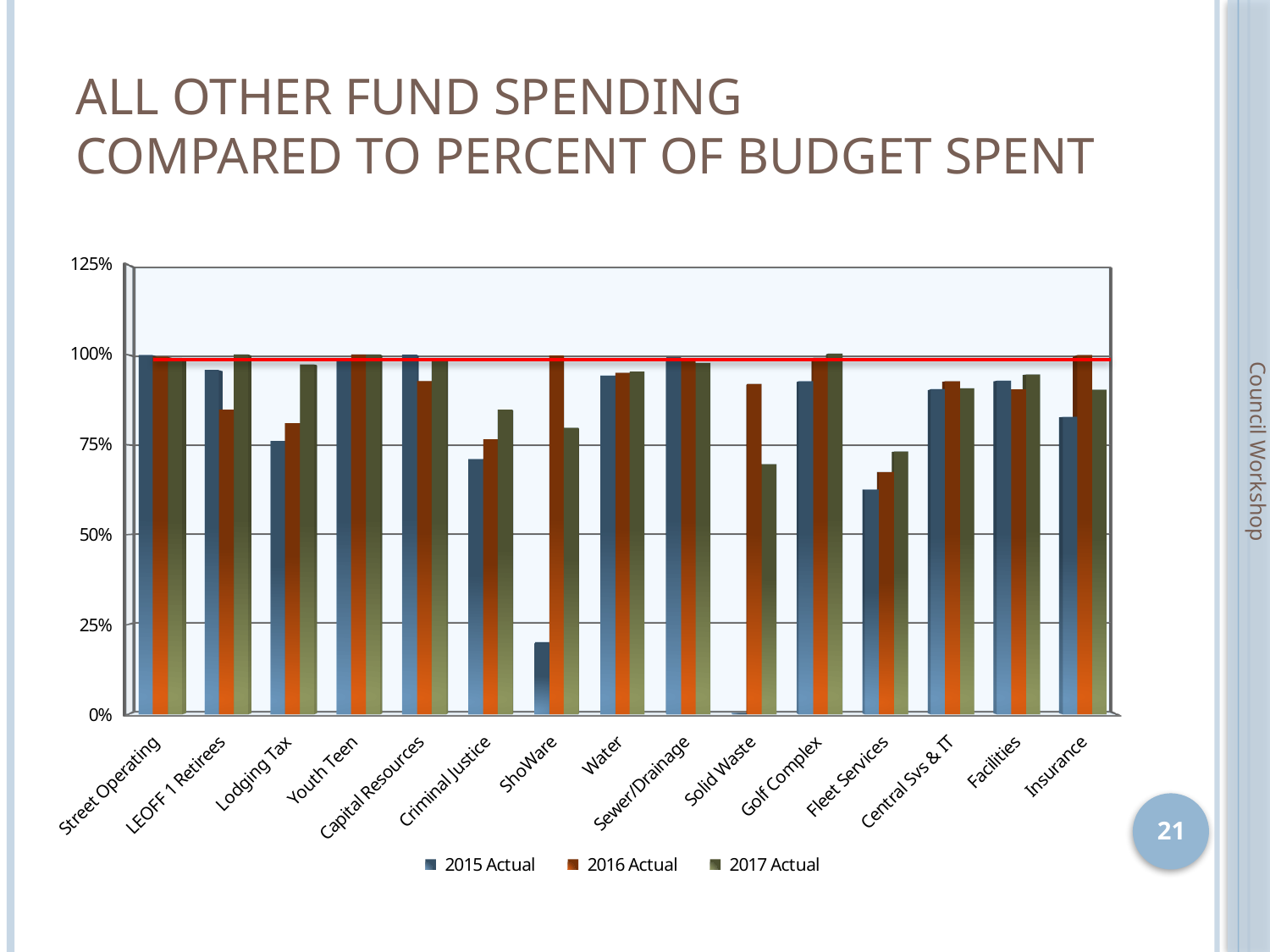
Which series is shown in orange in the legend? 2016 Actual How many fund categories are shown on the x axis? 15 Which category has the lowest 2015 Actual value? Solid Waste Is the 2015 Actual value for Fleet Services greater or less than 50%? greater Is the 2017 Actual value for Solid Waste greater or less than 75%? less Which category has the lowest 2016 Actual value? Fleet Services What kind of chart is shown on the slide? bar chart Is the 2016 Actual value for Lodging Tax greater or less than 75%? greater How many series does the legend list? 3 For Solid Waste, which is larger: the 2015 Actual value or the 2017 Actual value? 2017 Actual For ShoWare, which is larger: the 2015 Actual value or the 2016 Actual value? 2016 Actual